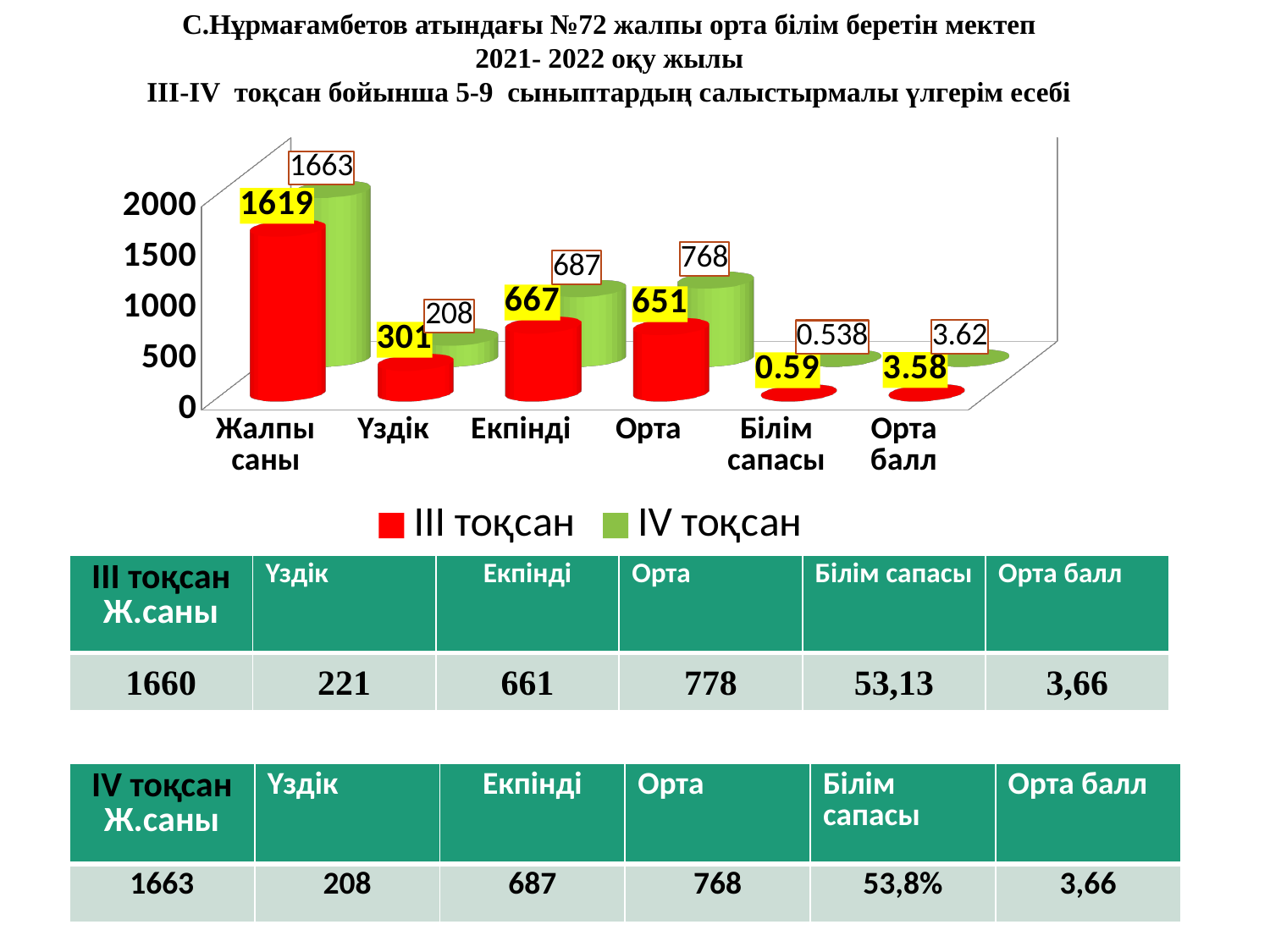
What is the value for Орта балл in the III тоқсан series? 3.58 Which category has the highest value in the IV тоқсан series? Жалпы саны What is the value for Жалпы саны in the III тоқсан series? 1619 How many categories are shown on the x axis of the chart? 6 Which is larger for Екпінді: the III тоқсан value or the IV тоқсан value? IV тоқсан What is the value for Үздік in the IV тоқсан series? 208 What is the value for Жалпы саны in the IV тоқсан series? 1663 What type of chart is shown on the slide? Bar chart What is the difference between the IV тоқсан and III тоқсан values for Орта? 117 What is the difference between the III тоқсан and IV тоқсан values for Үздік? 93 How many series does the chart legend list? 2 What is the value for Білім сапасы in the IV тоқсан series? 0.538